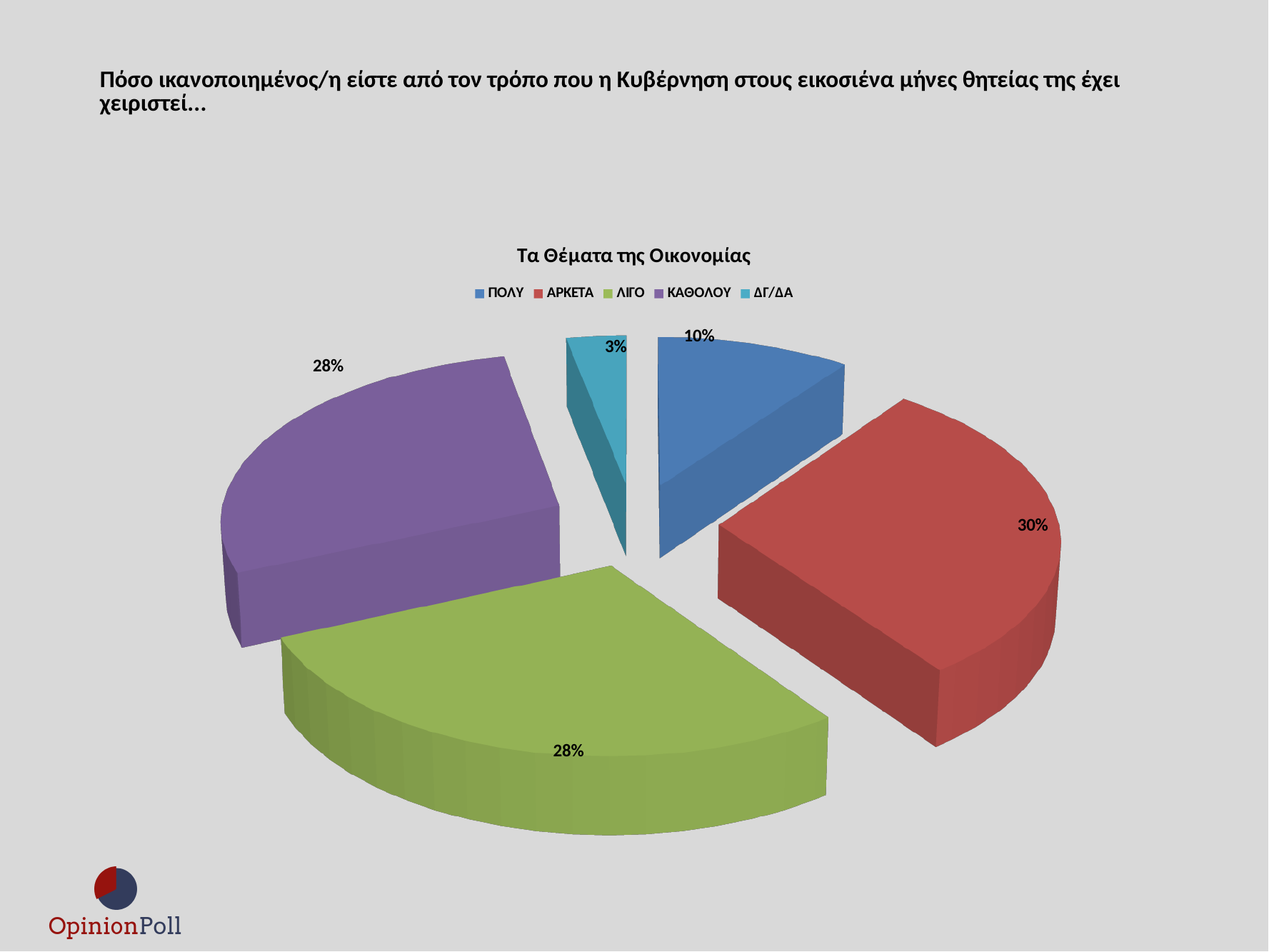
What percentage of respondents answered ΔΓ/ΔΑ? 3% What percentage of respondents answered ΑΡΚΕΤΑ? 30% What percentage of respondents answered ΠΟΛΥ? 10% Which is larger, the share for ΠΟΛΥ or the share for ΚΑΘΟΛΟΥ? ΚΑΘΟΛΟΥ What type of chart is shown on the slide? Pie chart What is the title of the chart? Τα Θέματα της Οικονομίας Which category has the smallest share of the pie? ΔΓ/ΔΑ Which category has the largest share of the pie? ΑΡΚΕΤΑ How many categories does the legend list? 5 What percentage of respondents answered ΛΙΓΟ? 28% What is the difference in percentage points between ΑΡΚΕΤΑ and ΠΟΛΥ? 20 What colour is the slice for ΚΑΘΟΛΟΥ? Purple